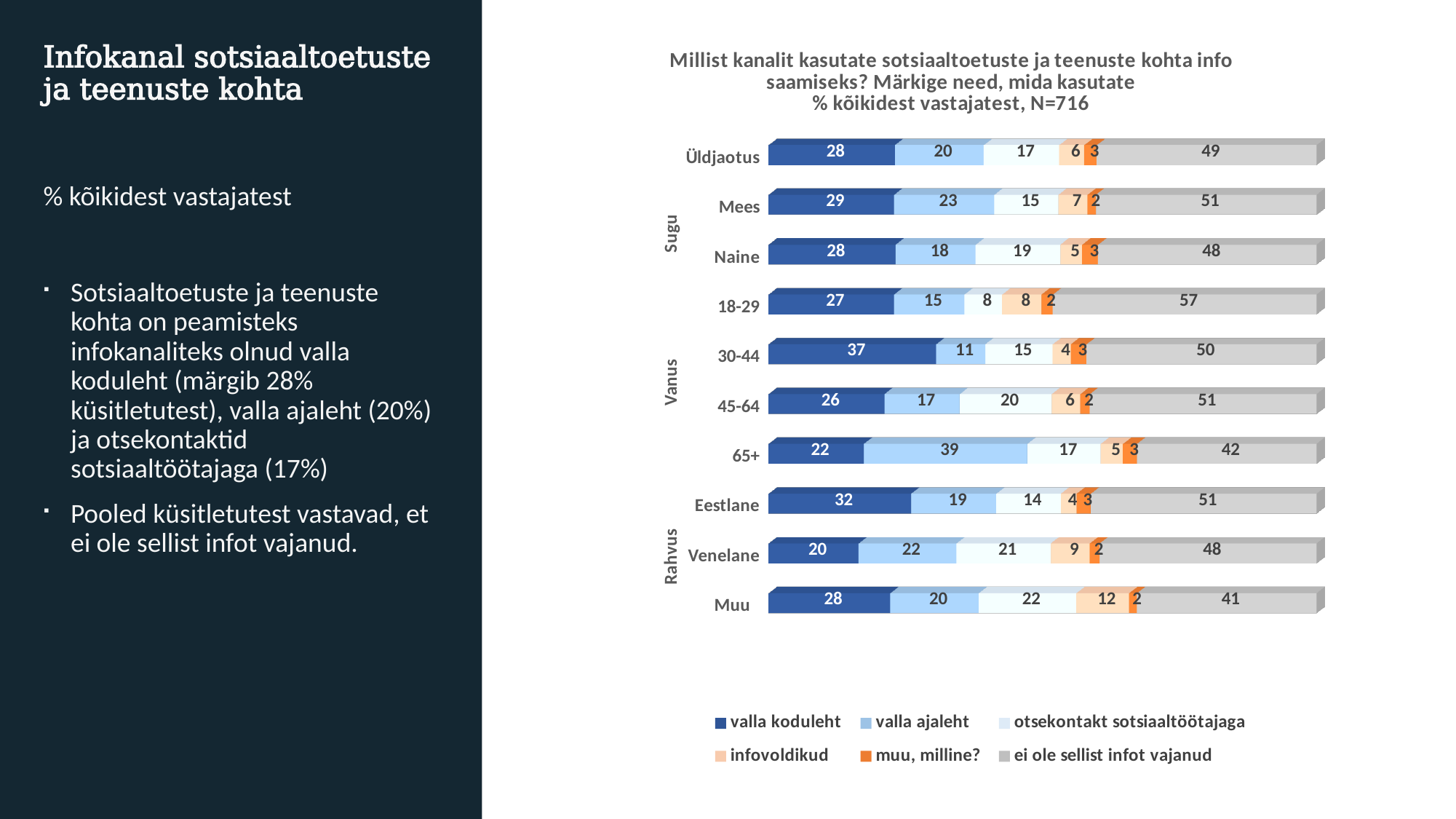
What is the value for 'ei ole sellist infot vajanud' in the 18-29 bar? 57 What is the total of all segments in the Üldjaotus bar? 123 How many categories (bars) are shown in the chart? 10 What is the difference between the 'valla koduleht' values for Eestlane and Venelane? 12 What kind of chart is shown on the slide? Stacked bar chart Which category has the highest value for 'valla koduleht'? 30-44 How many series does the legend list? 6 Which is larger: the 'infovoldikud' value for Muu or for Mees? Muu What is the value for 'valla ajaleht' in the 65+ bar? 39 What is the sample size (N) stated in the chart title? N=716 Which category has the lowest value for 'ei ole sellist infot vajanud'? Muu What is the value for 'valla koduleht' in the Üldjaotus bar? 28